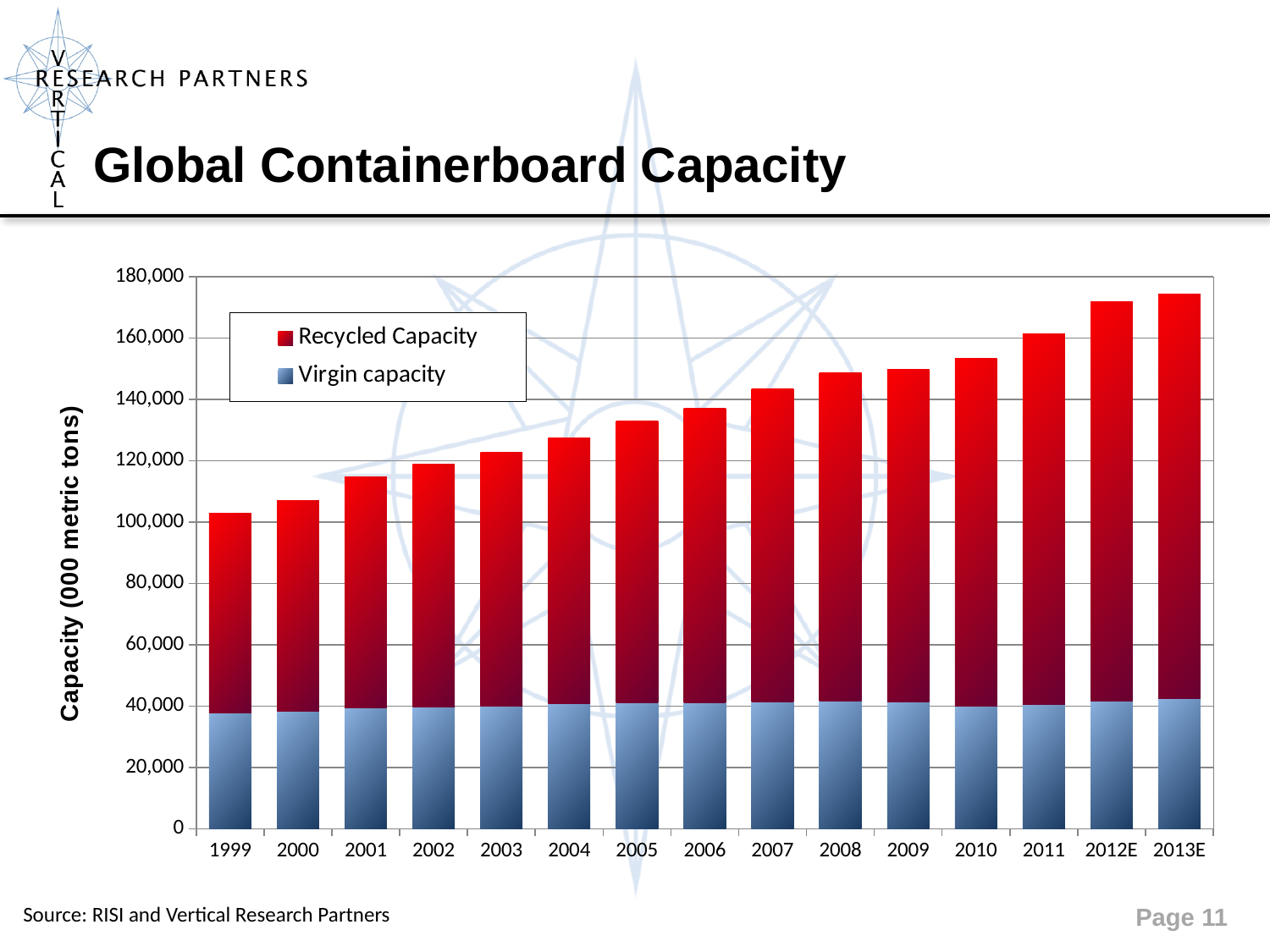
How many years (categories) are shown on the x axis? 15 Is the Virgin capacity for 2013E greater or less than 60,000? less Is the total capacity for 1999 greater or less than 100,000? greater Which year has the highest total containerboard capacity? 2013E Which year has the lowest total containerboard capacity? 1999 Which year has the larger total capacity, 2003 or 2008? 2008 What is the label on the vertical axis? Capacity (000 metric tons) Is the total capacity for 2005 greater or less than 120,000? greater How many series does the legend list? 2 What kind of chart is shown on the slide? bar chart Do total capacity values rise or fall from 1999 to 2013E? rise